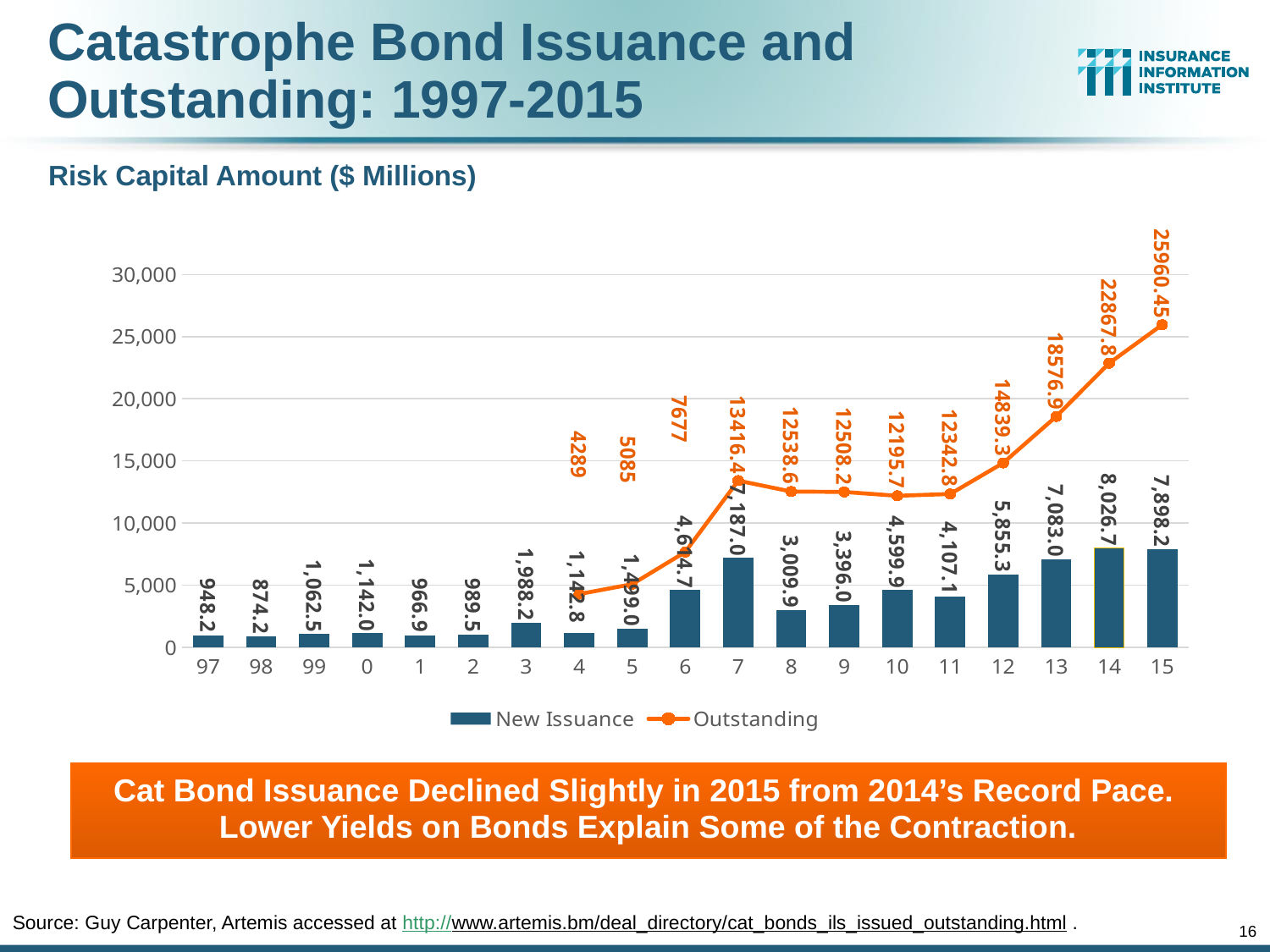
Which year has the lowest Outstanding value shown? 4 What is the difference between the New Issuance values for 14 and 15? 128.5 What is the New Issuance value for 2014 (labelled 14)? 8,026.7 How many years are shown on the x axis? 19 What kind of chart is this? Combined bar and line chart What is the Outstanding value for 2007 (labelled 7)? 13416.4 Which year has the lowest New Issuance value? 98 What is the New Issuance value for 1997 (labelled 97)? 948.2 Which year has the highest New Issuance value? 14 Which is larger, the New Issuance value for 7 or for 13? 7 What is the Outstanding value for 2015 (labelled 15)? 25960.45 How many series does the legend list? 2